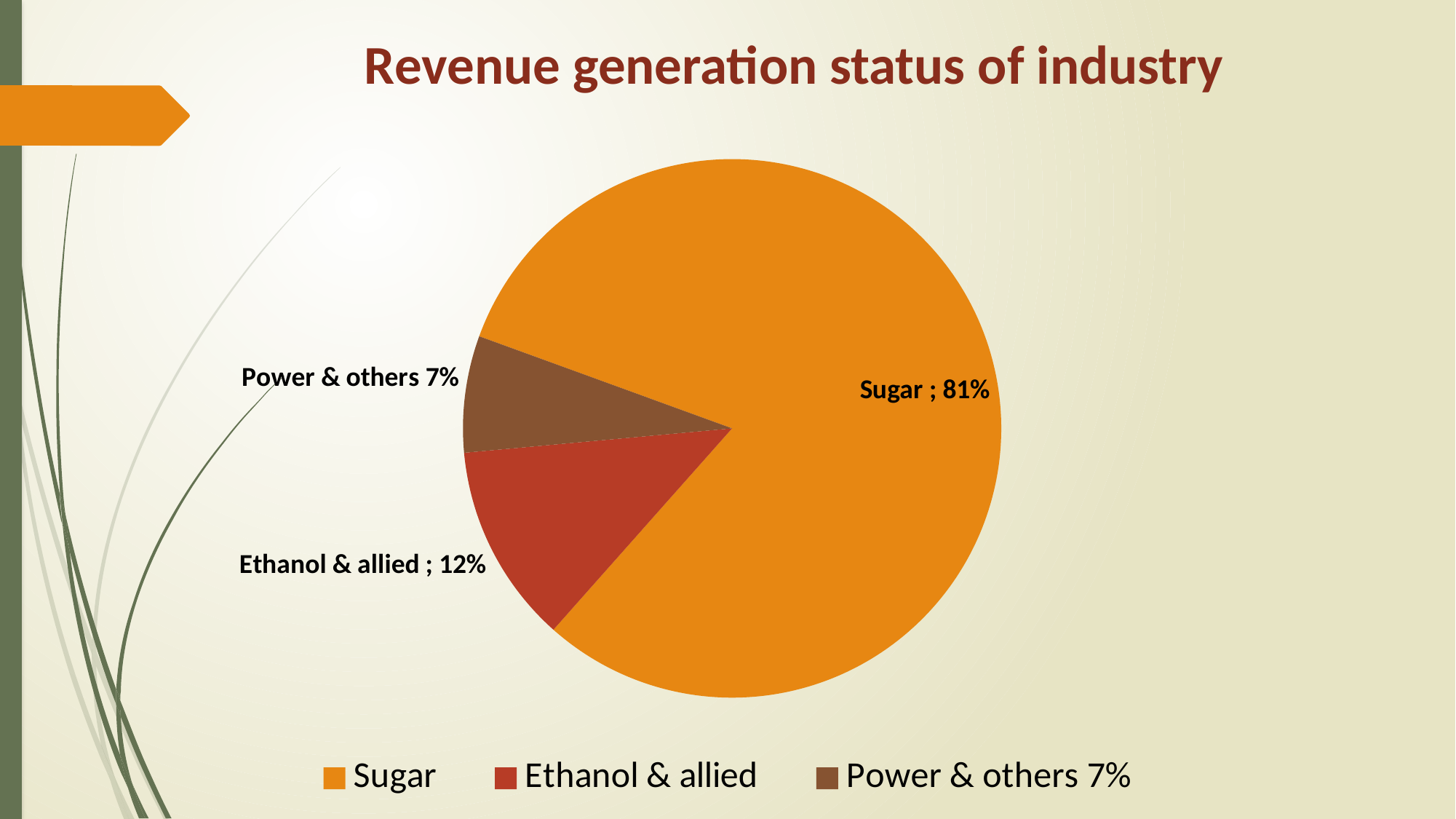
How many entries does the legend list? 3 What colour is the Sugar slice? orange Which category has the smallest share of the pie? Power & others Which is larger, the share for Ethanol & allied or the share for Power & others? Ethanol & allied What share of revenue does Ethanol & allied account for? 12% What type of chart is shown on the slide? pie chart Which category has the largest share of the pie? Sugar What is the title of the chart? Revenue generation status of industry What is the difference in percentage points between the Sugar share and the Ethanol & allied share? 69 What share of revenue does Power & others account for? 7% What share of revenue does Sugar account for? 81% How many slices does the pie chart have? 3